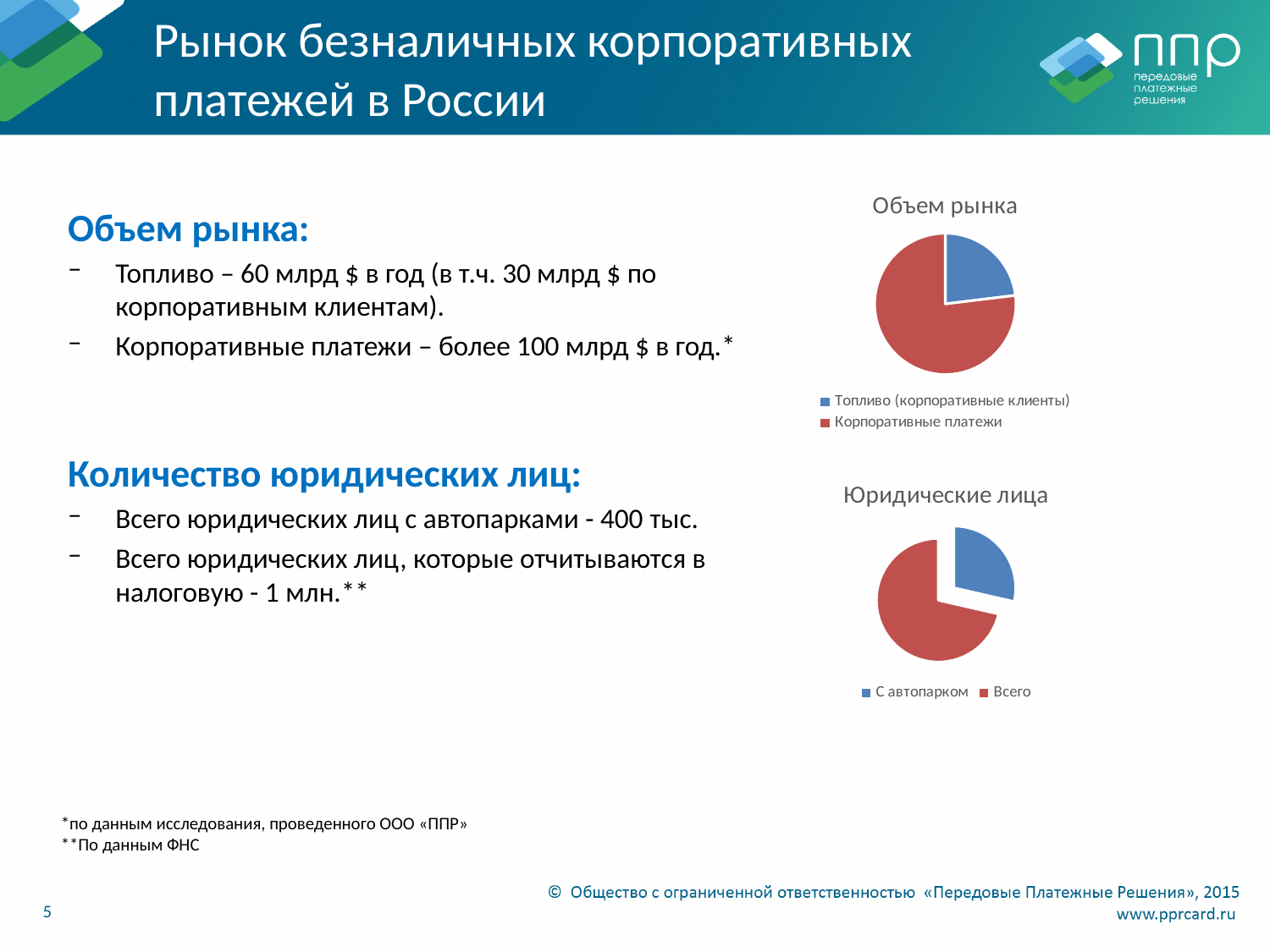
In the "Юридические лица" chart, what colour is the "С автопарком" slice? blue In the "Юридические лица" chart, which slice is the smallest? С автопарком In the "Объем рынка" chart, which is larger: Топливо (корпоративные клиенты) or Корпоративные платежи? Корпоративные платежи In the "Юридические лица" chart, which slice is the largest? Всего In the "Объем рынка" chart, which slice is the smallest? Топливо (корпоративные клиенты) In the "Юридические лица" chart, how many slices does the pie have? 2 In the "Юридические лица" chart, which is larger: С автопарком or Всего? Всего What kind of chart is the "Юридические лица" chart? pie chart What is the title of the upper pie chart on the slide? Объем рынка What kind of chart is the "Объем рынка" chart? pie chart In the "Объем рынка" chart, how many slices does the pie have? 2 In the "Объем рынка" chart, which slice is the largest? Корпоративные платежи